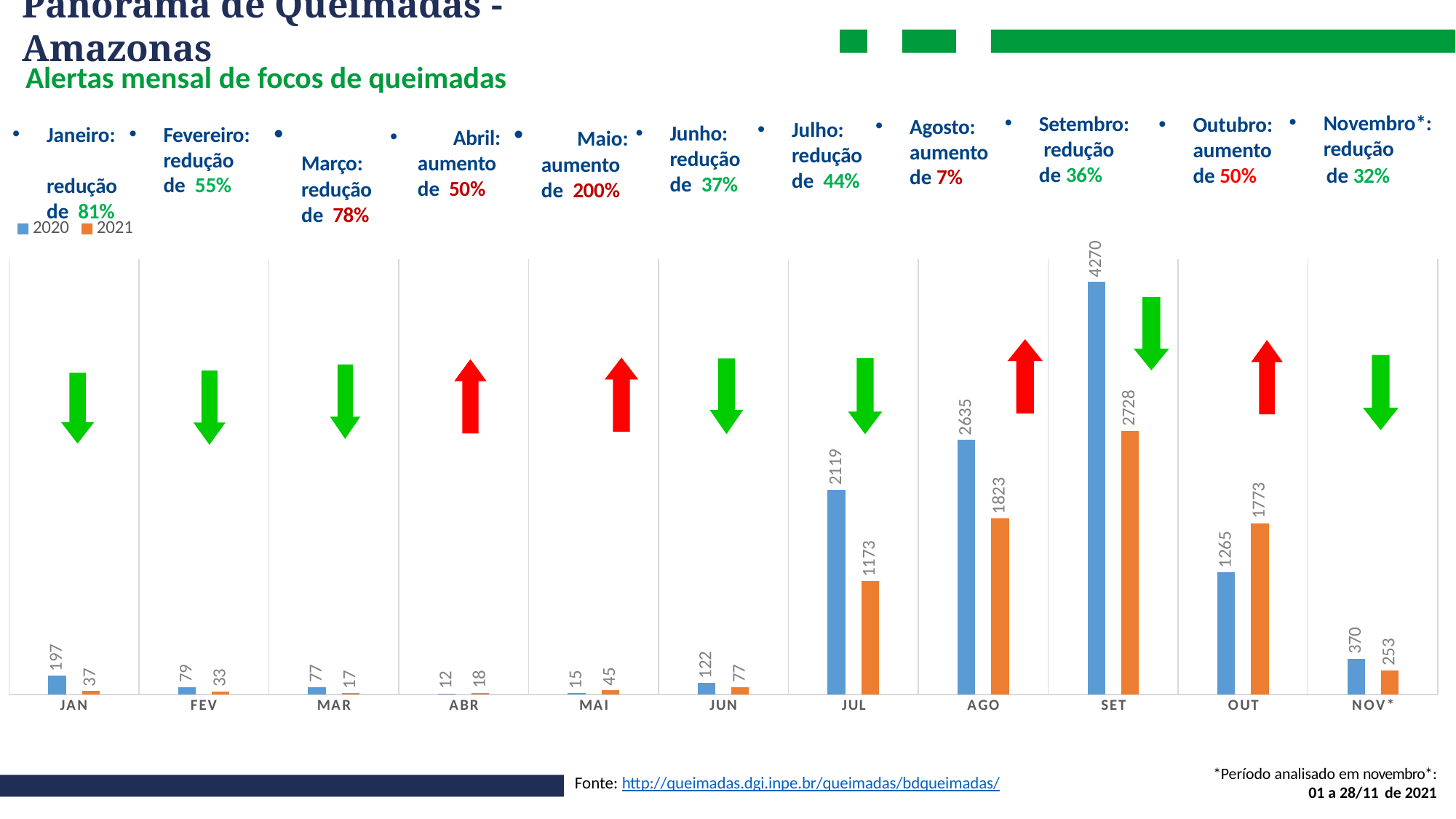
What is the value for 2021 in JUL? 1173 Which month has the lowest value for the 2020 series? ABR What is the difference between the 2020 and 2021 values in AGO? 812 What is the value for 2020 in SET? 4270 How many months are shown on the x axis? 11 How many series does the legend list? 2 What kind of chart is shown on the slide? bar chart What is the difference between the 2020 and 2021 values in SET? 1542 What is the value for 2021 in OUT? 1773 Which is larger in OUT, the 2020 value or the 2021 value? 2021 Which month has the highest value for the 2020 series? SET Which colour represents the 2021 series in the chart? orange